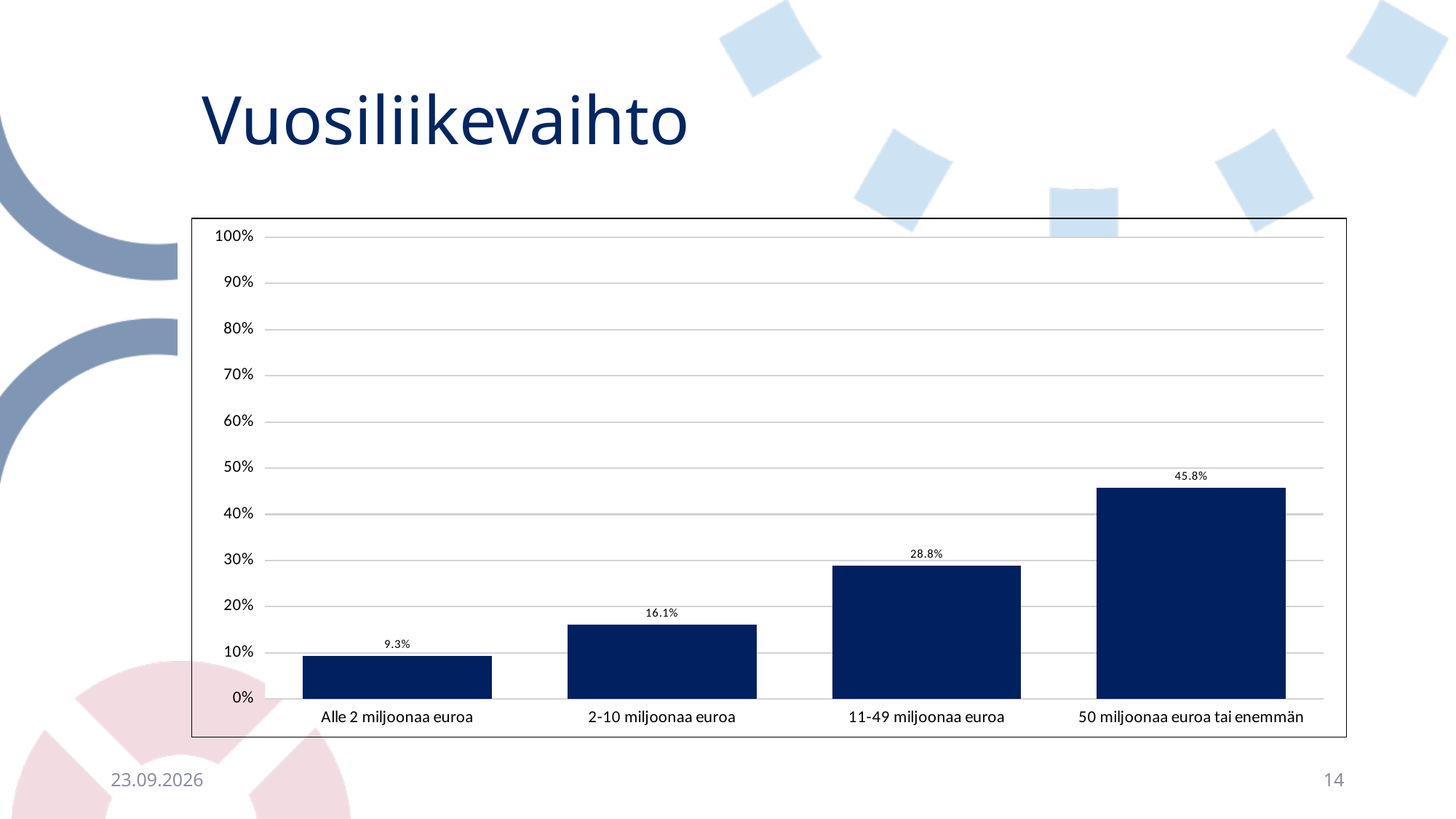
Do the values rise or fall from left to right along the x axis? rise What kind of chart is shown on the slide? bar chart Which category has the lowest value? Alle 2 miljoonaa euroa What is the value for '50 miljoonaa euroa tai enemmän'? 45.8% Which is larger, the value for '2-10 miljoonaa euroa' or the value for '11-49 miljoonaa euroa'? 11-49 miljoonaa euroa Which category has the highest value? 50 miljoonaa euroa tai enemmän What is the value for '2-10 miljoonaa euroa'? 16.1% What is the difference between the values for '50 miljoonaa euroa tai enemmän' and '11-49 miljoonaa euroa'? 17.0% What is the value for '11-49 miljoonaa euroa'? 28.8% Is the value for '50 miljoonaa euroa tai enemmän' greater or less than 50%? less How many categories are shown on the x axis? 4 What is the value for 'Alle 2 miljoonaa euroa'? 9.3%